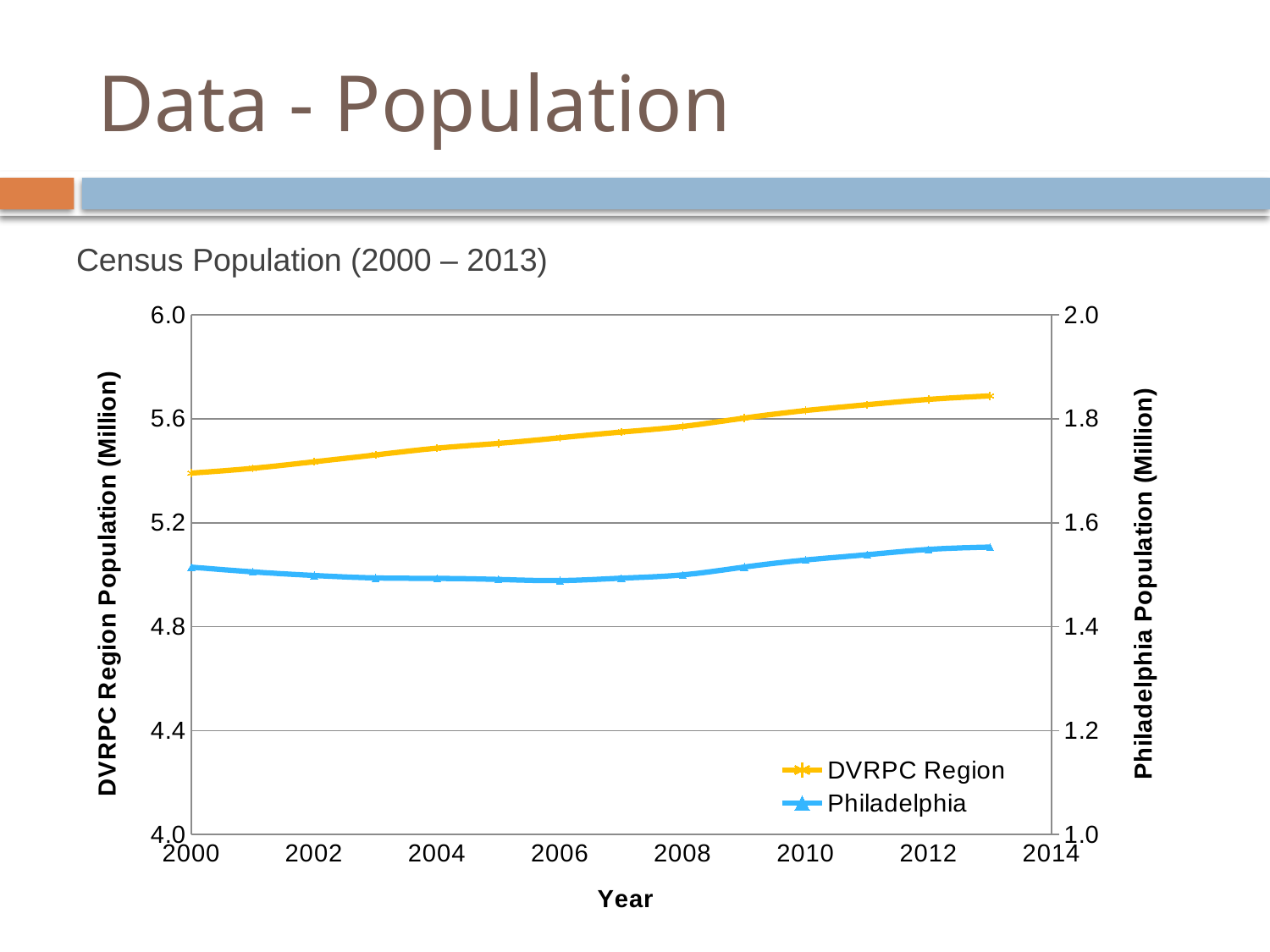
Is the DVRPC Region population in 2012 greater or less than 5.6 million? greater What is the title of the right-hand vertical axis? Philadelphia Population (Million) What kind of chart is shown on the slide? Line chart Which is larger: the Philadelphia population in 2006 or in 2013? 2013 In which year is the DVRPC Region population highest? 2013 Is the Philadelphia population in 2000 greater or less than 1.4 million? greater How many series does the legend list? 2 How many yearly data points are plotted for the DVRPC Region series? 14 Does the DVRPC Region population rise or fall from 2000 to 2013? Rise Does the Philadelphia population rise or fall from 2006 to 2013? Rise Is the DVRPC Region population in 2000 greater or less than 5.6 million? less